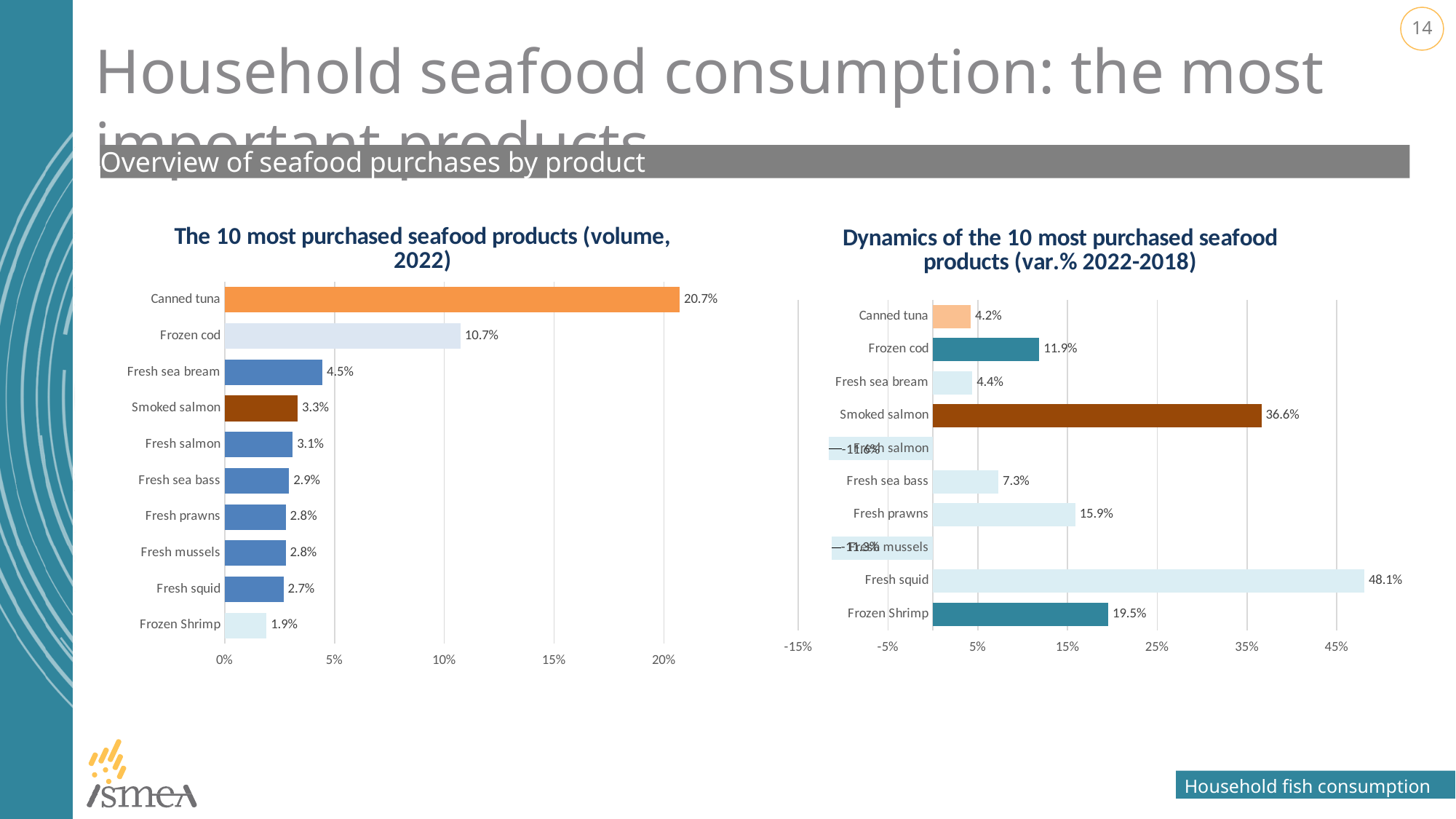
In the chart 'The 10 most purchased seafood products (volume, 2022)', what is the value for Canned tuna? 20.7% In the chart 'Dynamics of the 10 most purchased seafood products (var.% 2022-2018)', what is the value for Frozen Shrimp? 19.5% In the chart 'Dynamics of the 10 most purchased seafood products (var.% 2022-2018)', which product has the highest value? Fresh squid In the chart 'Dynamics of the 10 most purchased seafood products (var.% 2022-2018)', which is larger, Frozen cod or Fresh prawns? Fresh prawns In the chart 'The 10 most purchased seafood products (volume, 2022)', what is the difference between Canned tuna and Frozen cod? 10.0% In the chart 'The 10 most purchased seafood products (volume, 2022)', what is the value for Fresh sea bream? 4.5% In the chart 'The 10 most purchased seafood products (volume, 2022)', which product has the lowest value? Frozen Shrimp What kind of chart is 'The 10 most purchased seafood products (volume, 2022)'? Bar chart In the chart 'The 10 most purchased seafood products (volume, 2022)', how many products are shown? 10 In the chart 'Dynamics of the 10 most purchased seafood products (var.% 2022-2018)', is the value for Fresh salmon greater or less than -5%? less In the chart 'The 10 most purchased seafood products (volume, 2022)', what colour is the bar for Canned tuna? Orange In the chart 'Dynamics of the 10 most purchased seafood products (var.% 2022-2018)', what is the value for Smoked salmon? 36.6%